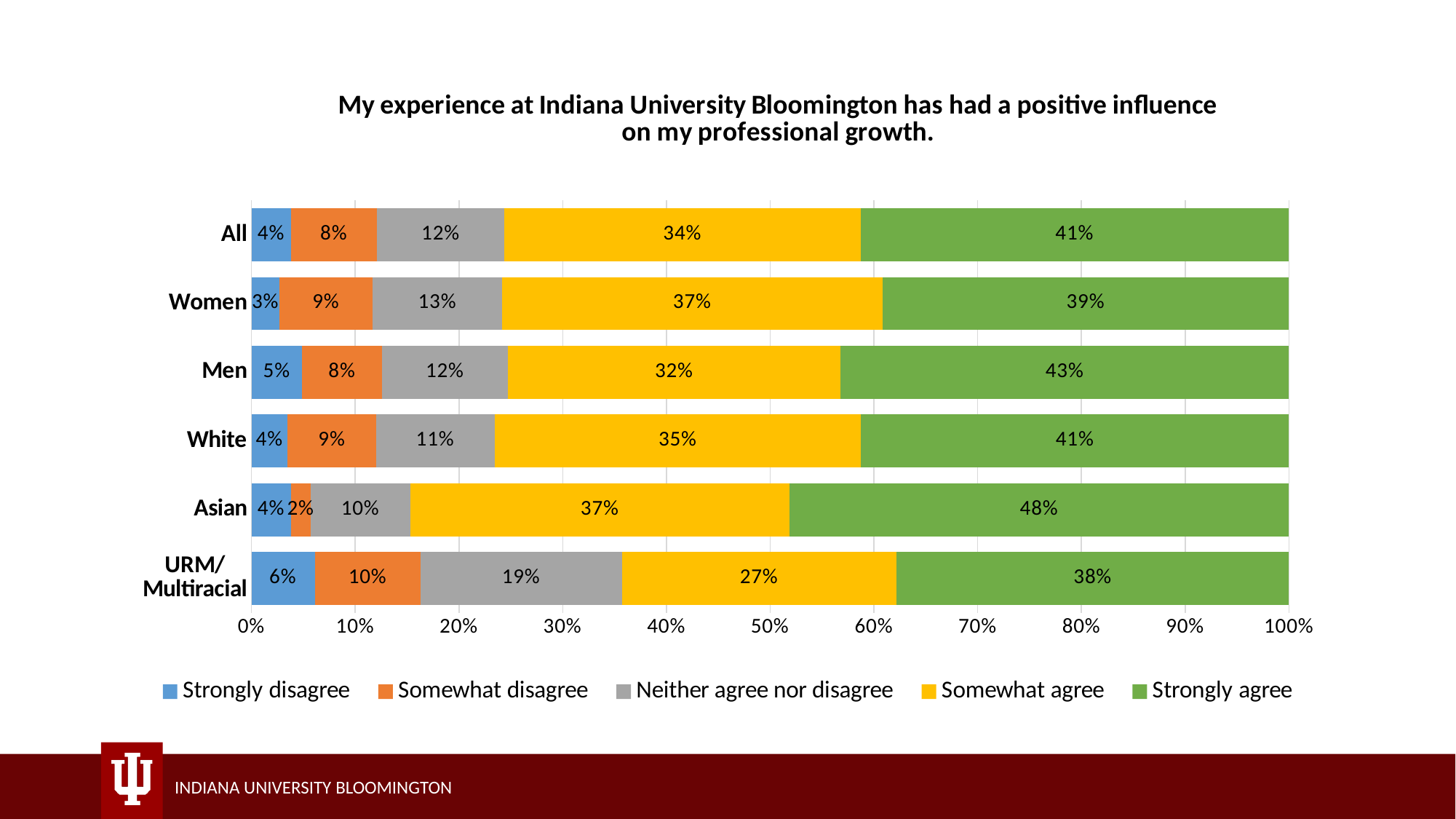
What is the combined percentage of "Strongly disagree" and "Somewhat disagree" for the URM/Multiracial group? 16% Which group has the highest "Strongly agree" percentage? Asian What type of chart is shown on the slide? Stacked bar chart Which group has a larger "Somewhat agree" share, Women or Men? Women What percentage of Asian respondents selected "Strongly agree"? 48% How many response categories does the legend list? 5 What is the "Neither agree nor disagree" value for the URM/Multiracial group? 19% Which group has the highest "Neither agree nor disagree" percentage? URM/Multiracial How many percentage points higher is "Strongly agree" for Men than for Women? 4 percentage points What percentage of Women selected "Somewhat agree"? 37% Which group has the lowest "Strongly agree" percentage? URM/Multiracial How many groups are shown on the chart? 6